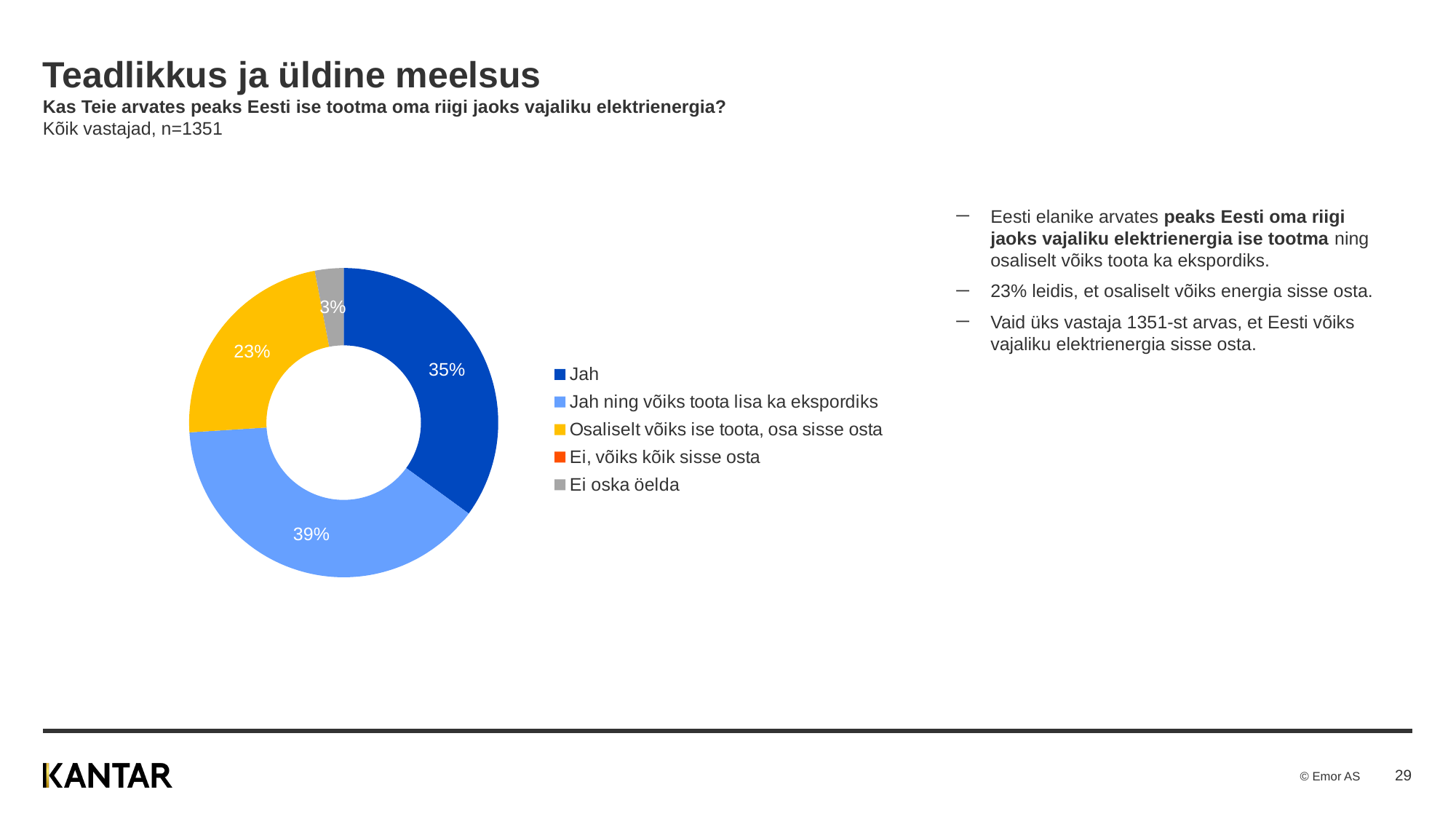
Which is larger: the share for "Jah" or the share for "Osaliselt võiks ise toota, osa sisse osta"? Jah What share of respondents answered "Jah ning võiks toota lisa ka ekspordiks"? 39% What is the difference in percentage points between "Jah ning võiks toota lisa ka ekspordiks" and "Jah"? 4 percentage points What share of respondents answered "Ei oska öelda"? 3% What share of respondents answered "Osaliselt võiks ise toota, osa sisse osta"? 23% Which answer category has the largest share of the chart? Jah ning võiks toota lisa ka ekspordiks What share of respondents answered "Jah"? 35% What kind of chart is shown on the slide? Doughnut (pie) chart How many answer categories does the legend list? 5 What colour represents "Osaliselt võiks ise toota, osa sisse osta" in the chart? Yellow What is the combined share of "Jah" and "Jah ning võiks toota lisa ka ekspordiks"? 74% Which labelled answer category has the smallest share of the chart? Ei oska öelda